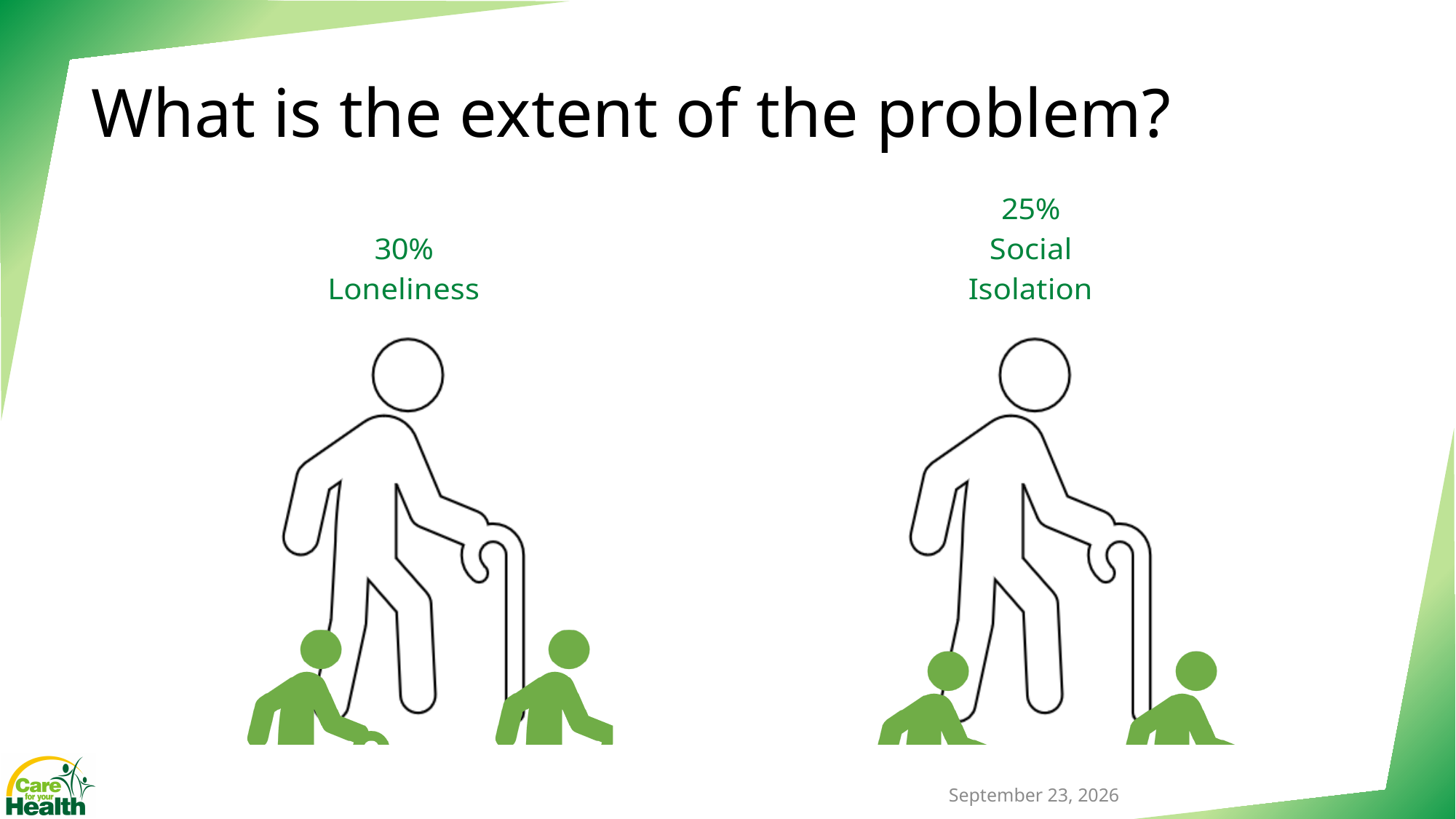
What is the title of the slide? What is the extent of the problem? Which is higher, the percentage for Loneliness or for Social Isolation? Loneliness Which category is shown on the left side of the slide? Loneliness Which of the two categories shown has the highest percentage? Loneliness What percentage is shown for Social Isolation? 25% What is the difference between the Loneliness percentage and the Social Isolation percentage? 5% Which of the two categories shown has the lowest percentage? Social Isolation What percentage is shown for Loneliness? 30% How many categories with percentages are shown on the slide? 2